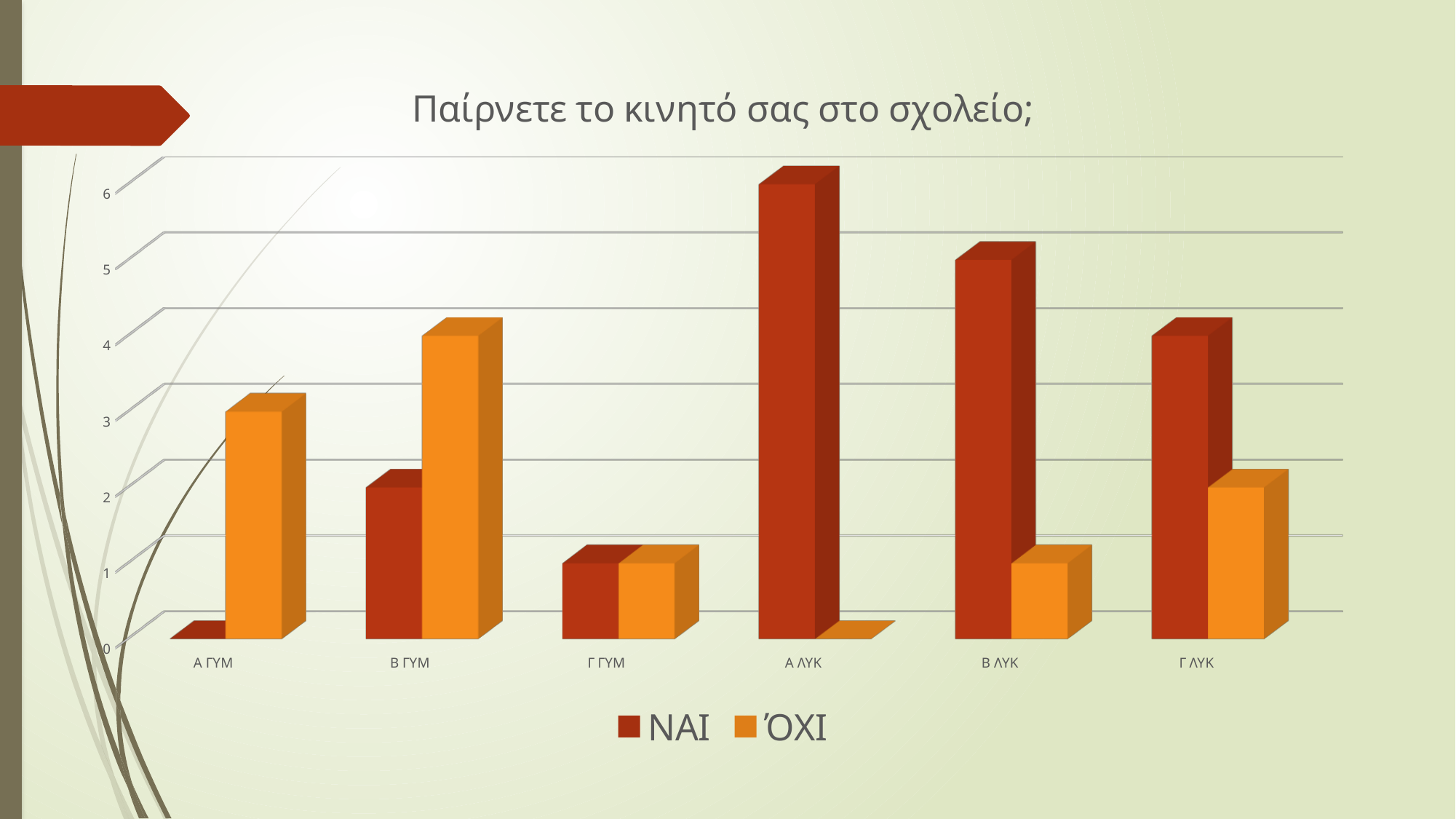
How many series does the legend list? 2 Which colour represents the ΌΧΙ series? orange Which category has the highest ΝΑΙ value? Α ΛΥΚ What is the ΝΑΙ value for Α ΛΥΚ? 6 Is the ΌΧΙ value for Α ΓΥΜ greater or less than 2? greater What is the ΝΑΙ value for Β ΛΥΚ? 5 What is the ΌΧΙ value for Β ΓΥΜ? 4 Which category has the highest ΌΧΙ value? Β ΓΥΜ What is the title of the chart? Παίρνετε το κινητό σας στο σχολείο; Which is larger for Γ ΛΥΚ, the ΝΑΙ value or the ΌΧΙ value? ΝΑΙ What kind of chart is shown on the slide? bar chart How many categories are shown on the x axis? 6